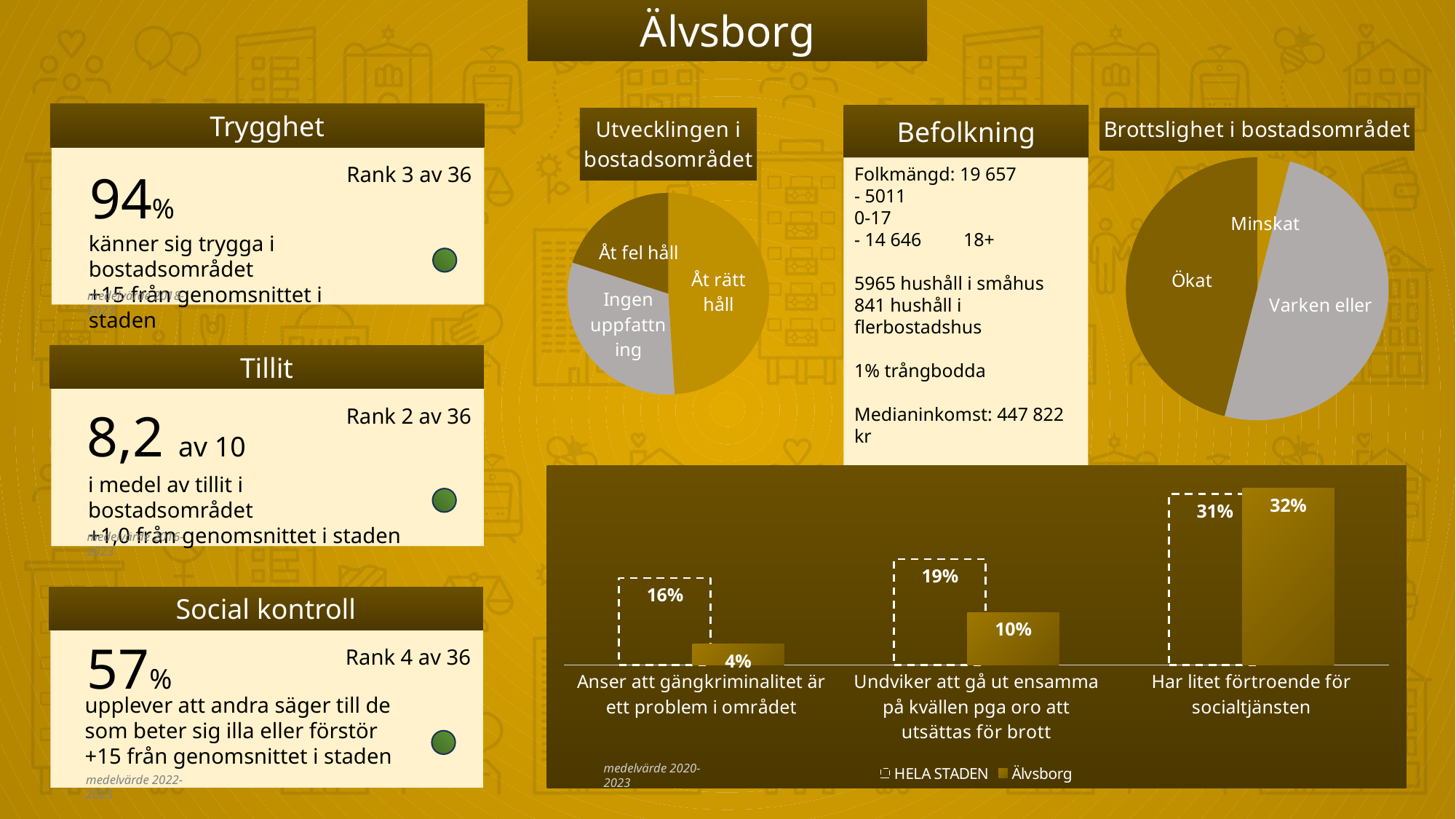
In the bottom bar chart, what is the value for Älvsborg for 'Har litet förtroende för socialtjänsten'? 32% In the bottom bar chart, which category has the highest value for Älvsborg? Har litet förtroende för socialtjänsten How many slices does the 'Utvecklingen i bostadsområdet' pie chart have? 3 How many series does the legend of the bottom bar chart list? 2 In the bottom bar chart, which category has the lowest value for HELA STADEN? Anser att gängkriminalitet är ett problem i området In the bottom bar chart, what is the value for Älvsborg for 'Anser att gängkriminalitet är ett problem i området'? 4% How many categories are shown in the bottom bar chart? 3 In the bottom bar chart, what is the difference between HELA STADEN and Älvsborg for 'Anser att gängkriminalitet är ett problem i området'? 12% What kind of chart is 'Utvecklingen i bostadsområdet'? Pie chart In the bottom bar chart, which is larger for 'Undviker att gå ut ensamma på kvällen pga oro att utsättas för brott': HELA STADEN or Älvsborg? HELA STADEN In the bottom bar chart, what is the value for HELA STADEN for 'Undviker att gå ut ensamma på kvällen pga oro att utsättas för brott'? 19% In the 'Brottslighet i bostadsområdet' pie chart, which slice is the smallest? Minskat